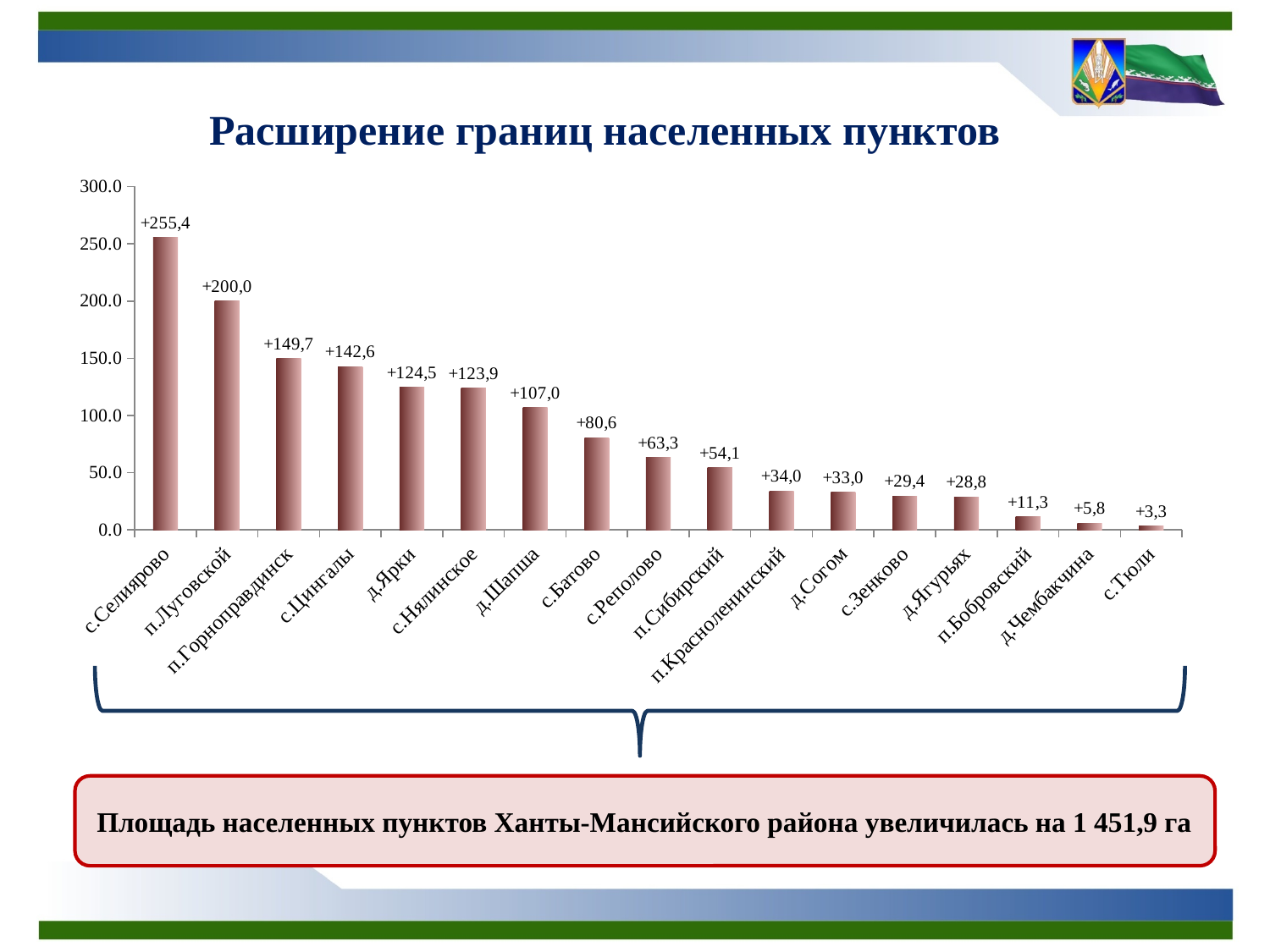
Which has a larger value, с.Батово or с.Реполово? с.Батово Do the values rise or fall from left to right along the x axis? fall How many settlements are shown in the chart? 17 Which settlement has the lowest value in the chart? с.Тюли What is the value shown for с.Селиярово? +255,4 What is the difference between the values for п.Горноправдинск and с.Цингалы? 7,1 Which settlement has the highest value in the chart? с.Селиярово What is the title of the chart? Расширение границ населенных пунктов What is the value shown for п.Бобровский? +11,3 What is the difference between the values for с.Селиярово and п.Луговской? 55,4 What kind of chart is shown on the slide? bar chart What is the value shown for д.Шапша? +107,0